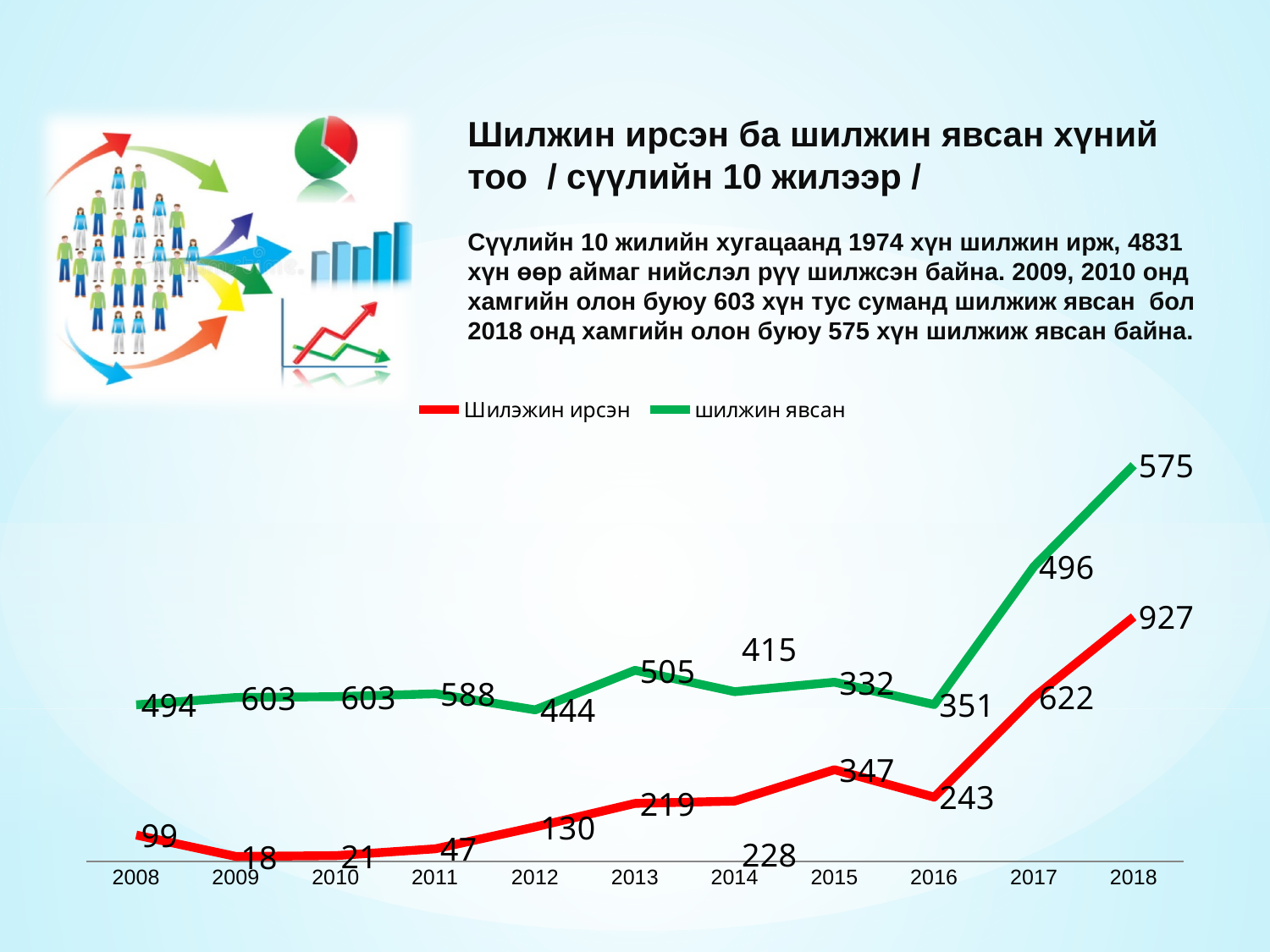
In which year is the 'Шилэжин ирсэн' series at its lowest? 2009 How many years are shown on the x axis of the chart? 11 In 2013, which series has the larger value, 'Шилэжин ирсэн' or 'шилжин явсан'? шилжин явсан What kind of chart is shown on the slide? line chart What is the value of the 'Шилэжин ирсэн' series in 2018? 927 How many series does the legend list? 2 Does the 'шилжин явсан' series rise or fall from 2016 to 2018? rise In which year is the 'Шилэжин ирсэн' series at its highest? 2018 What is the value of the 'шилжин явсан' series in 2008? 494 By how much did the 'Шилэжин ирсэн' series increase from 2017 to 2018? 305 What is the value of the 'шилжин явсан' series in 2012? 444 What is the value of the 'Шилэжин ирсэн' series in 2013? 219